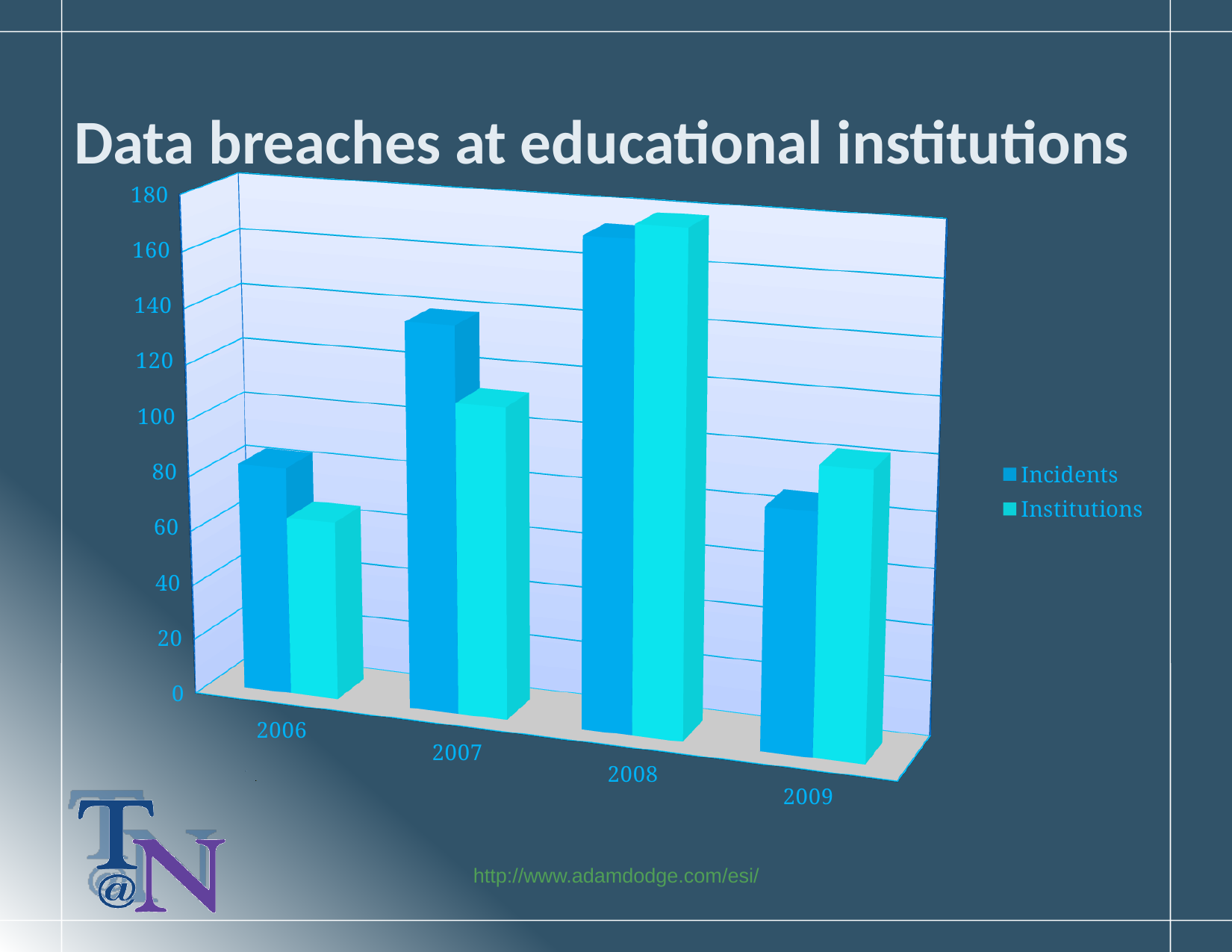
What is the title of the chart? Data breaches at educational institutions Is the Incidents value for 2007 greater or less than 120? greater Is the Institutions value for 2006 greater or less than 80? less How many series does the legend list? 2 In 2006, which is larger, Incidents or Institutions? Incidents What kind of chart is shown on the slide? Bar chart How many years are shown on the x axis? 4 What are the two series named in the legend? Incidents and Institutions In which year is the Institutions value lowest? 2006 In which year is the Incidents value highest? 2008 In 2007, which is larger, Incidents or Institutions? Incidents Do the Incidents values rise or fall from 2006 to 2008? rise